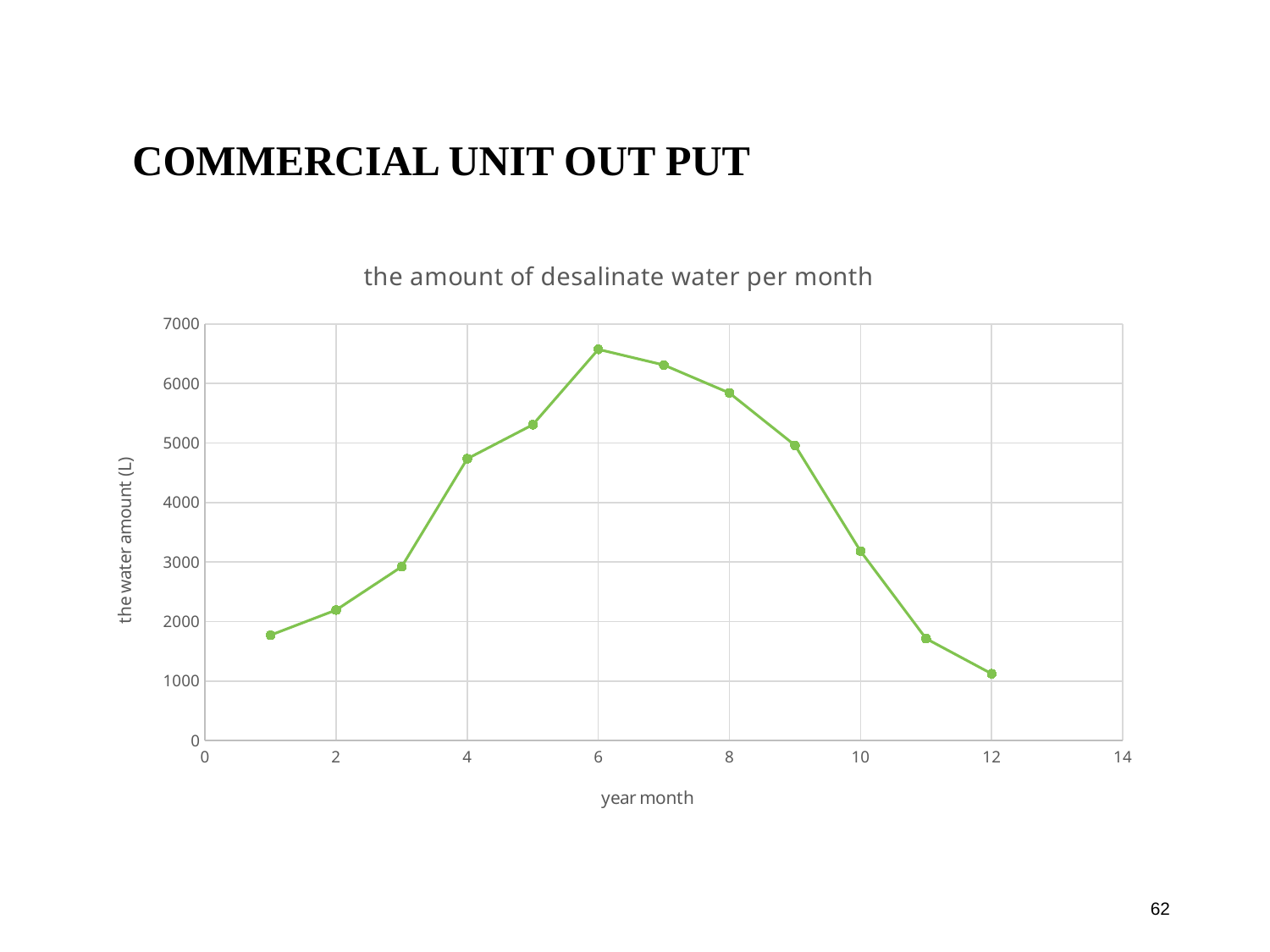
What kind of chart is shown on the slide? line chart Is the water amount for month 4 greater or less than 4000? greater Which has a larger water amount, month 4 or month 10? month 4 Do the values rise or fall from month 6 to month 12? fall Which month has the lowest water amount? 12 Is the water amount for month 6 greater or less than 6000? greater What is the title of the chart? the amount of desalinate water per month What is the label of the vertical axis? the water amount (L) Is the water amount for month 10 greater or less than 4000? less How many data points are plotted on the line? 12 Which month has the highest water amount? 6